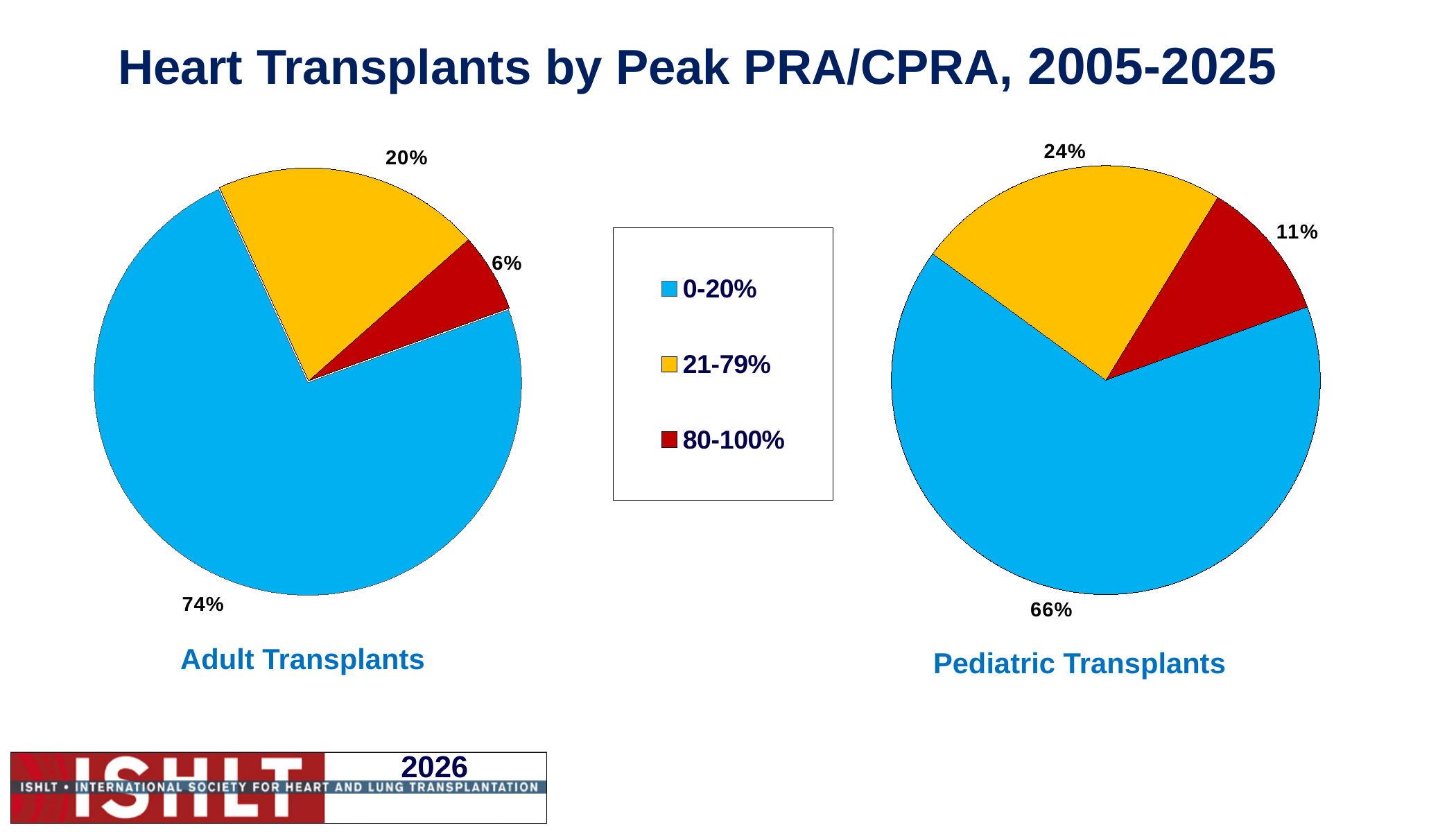
In the Pediatric Transplants pie chart, what share of heart transplants had a peak PRA/CPRA of 80-100%? 11% What type of chart is used for the Adult Transplants data? Pie chart In the Adult Transplants pie chart, which peak PRA/CPRA category has the smallest share? 80-100% In the Pediatric Transplants pie chart, which peak PRA/CPRA category has the largest share? 0-20% What is the difference between the 0-20% share in the Adult Transplants chart and the 0-20% share in the Pediatric Transplants chart? 8% Which chart shows a larger share for the 80-100% peak PRA/CPRA category, Adult Transplants or Pediatric Transplants? Pediatric Transplants How many categories does the legend list for the pie charts? 3 In the Adult Transplants pie chart, what share of heart transplants had a peak PRA/CPRA of 21-79%? 20% In the Adult Transplants pie chart, what share of heart transplants had a peak PRA/CPRA of 0-20%? 74% In the Pediatric Transplants pie chart, what share of heart transplants had a peak PRA/CPRA of 0-20%? 66% Which colour represents the 21-79% peak PRA/CPRA category in the pie charts? Yellow In the Adult Transplants pie chart, what share of heart transplants had a peak PRA/CPRA of 80-100%? 6%